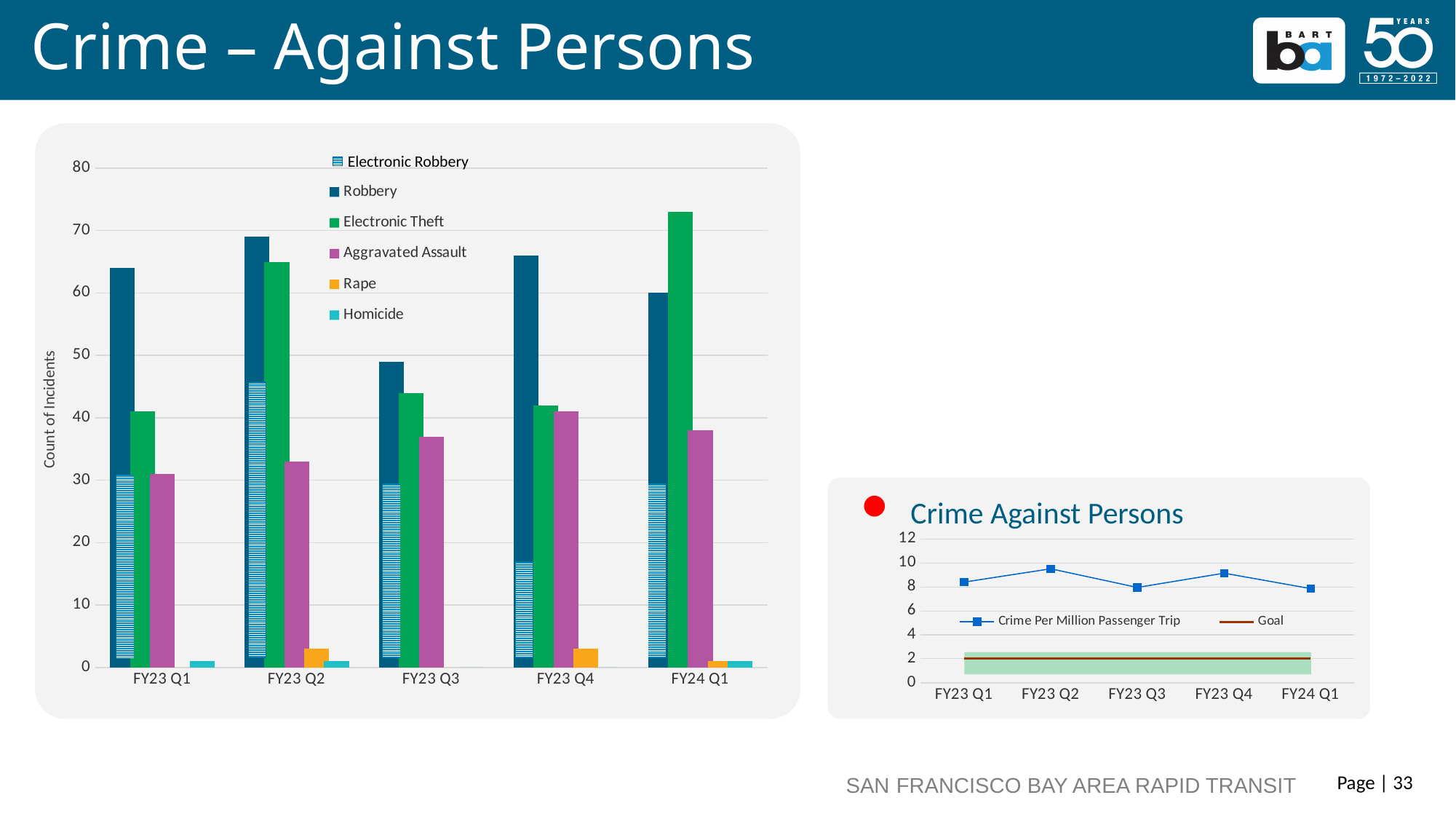
On the left bar chart, in which quarter is the Aggravated Assault bar highest? FY23 Q4 On the left bar chart, how many series does the legend list? 6 What kind of chart is the chart on the left of the slide? bar chart On the left bar chart, how many quarters are shown on the x axis? 5 On the left bar chart, in FY24 Q1, which is larger: Robbery or Electronic Theft? Electronic Theft On the left bar chart, is the Electronic Theft value for FY24 Q1 greater or less than 70? greater On the 'Crime Against Persons' chart, how many series does the legend list? 2 On the left bar chart, in which quarter is the Electronic Theft bar highest? FY24 Q1 On the left bar chart, in which quarter is the Robbery bar highest? FY23 Q2 On the left bar chart, is the Aggravated Assault value for FY23 Q1 greater or less than 40? less On the left bar chart, in which quarter is the Robbery bar lowest? FY23 Q3